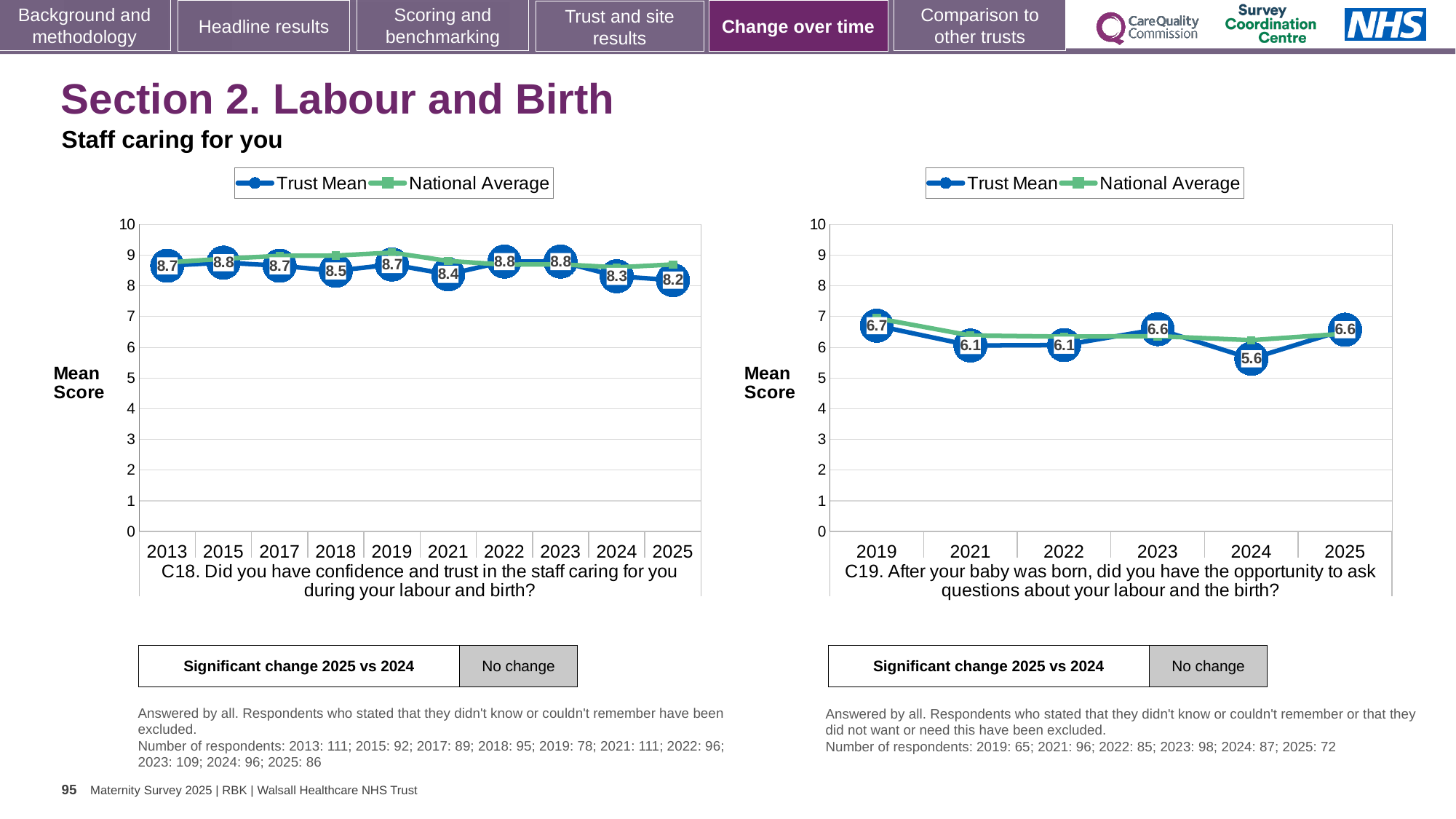
In the C19 chart on the right, what is the difference between the Trust Mean scores for 2019 and 2024? 1.1 In the C18 chart on the left, what is the Trust Mean score for 2018? 8.5 In the C19 chart on the right, which year has the lowest Trust Mean score? 2024 What type of chart is the C18 chart on the left? Line chart How many years are plotted on the x axis of the C18 chart on the left? 10 In the C18 chart on the left, which year has the lowest Trust Mean score? 2025 In the C19 chart on the right, what is the Trust Mean score for 2019? 6.7 How many series does the legend of the C19 chart on the right list? 2 In the C19 chart on the right, what is the Trust Mean score for 2024? 5.6 In the C18 chart on the left, what is the Trust Mean score for 2025? 8.2 In the C18 chart on the left, what is the difference between the Trust Mean scores for 2013 and 2025? 0.5 In the C19 chart on the right, which year has the higher Trust Mean score, 2021 or 2023? 2023